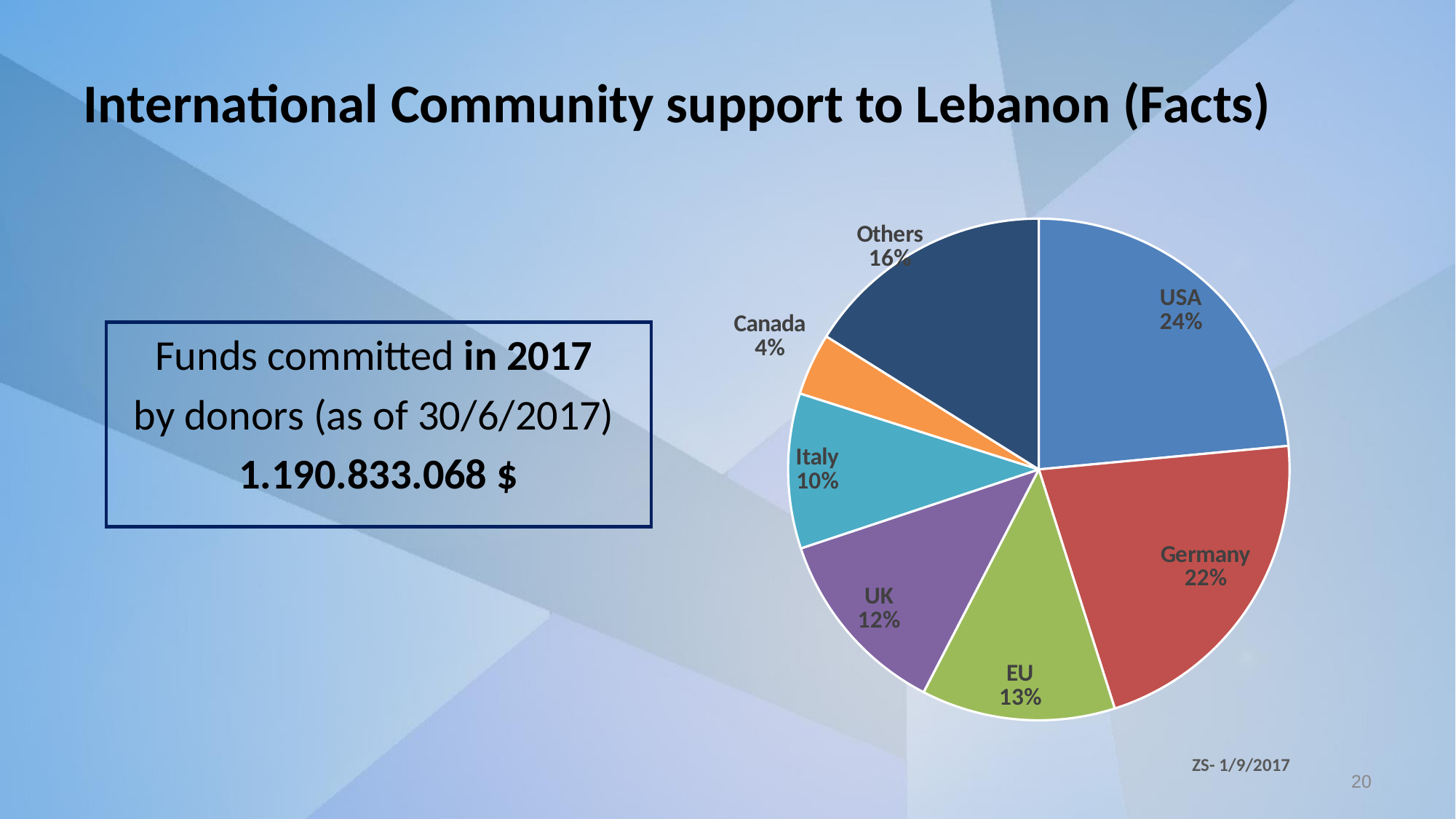
What kind of chart is shown on the slide? Pie chart Which donor has the smallest slice of the pie? Canada How many slices does the pie chart have? 7 What is the value shown for Canada? 4% What is the combined share of the UK and Italy slices? 22% What colour is the Germany slice? Red What is the difference in percentage points between the USA and Italy slices? 14 What share of the pie does the USA slice represent? 24% Which donor has the largest slice of the pie? USA What is the value shown for Germany? 22% Which is larger, the EU slice or the UK slice? EU What is the value shown for Others? 16%